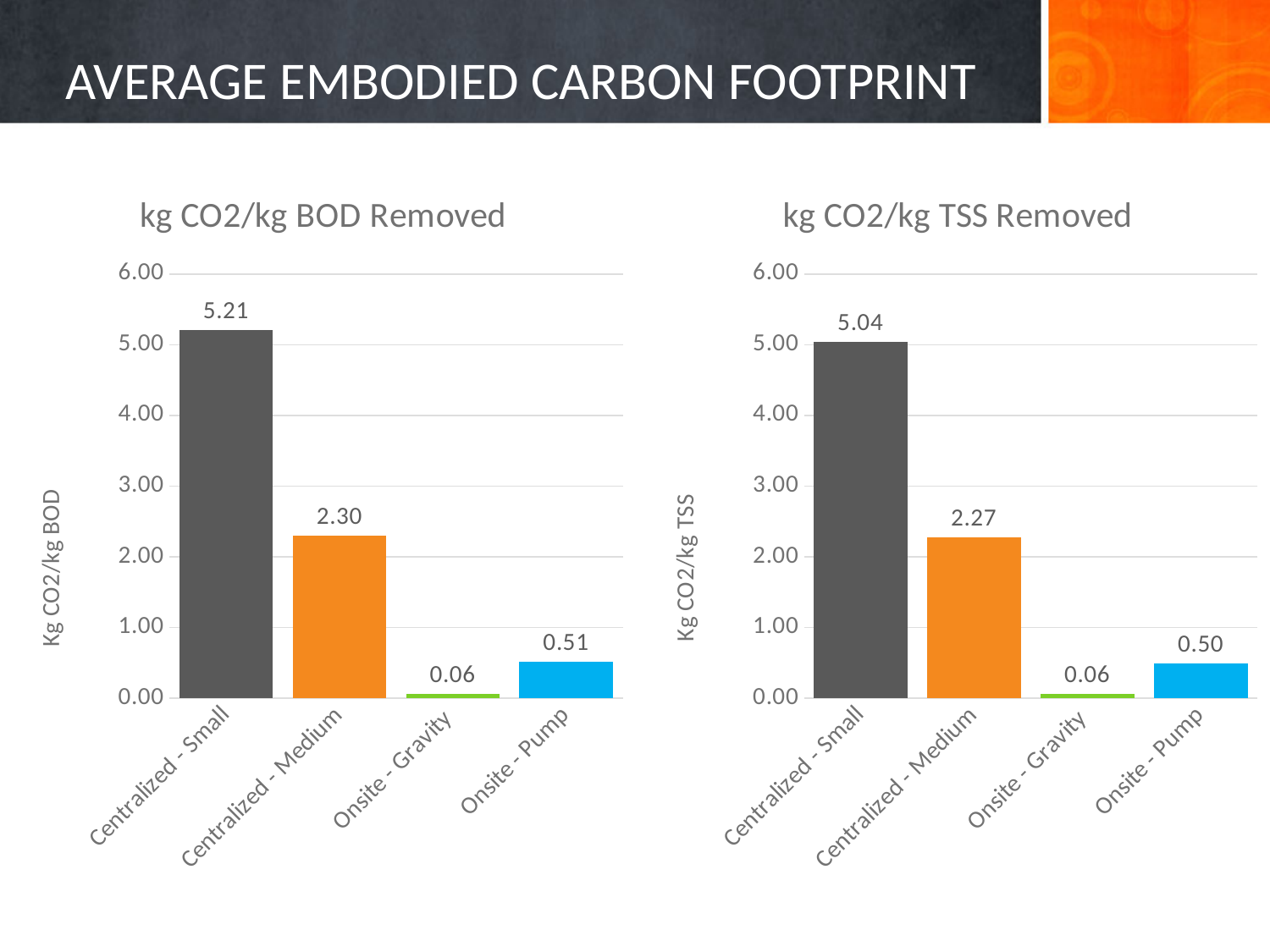
How many categories are shown in the 'kg CO2/kg BOD Removed' chart? 4 In the 'kg CO2/kg BOD Removed' chart, which category has the highest value? Centralized - Small In the 'kg CO2/kg BOD Removed' chart, what is the value for Centralized - Small? 5.21 In the 'kg CO2/kg TSS Removed' chart, what is the difference between Onsite - Pump and Onsite - Gravity? 0.44 In the 'kg CO2/kg TSS Removed' chart, which category has the lowest value? Onsite - Gravity In the 'kg CO2/kg BOD Removed' chart, which is larger: Onsite - Pump or Onsite - Gravity? Onsite - Pump In the 'kg CO2/kg BOD Removed' chart, what is the difference between Centralized - Small and Centralized - Medium? 2.91 What is the y-axis label of the 'kg CO2/kg BOD Removed' chart? Kg CO2/kg BOD In the 'kg CO2/kg TSS Removed' chart, what is the value for Centralized - Medium? 2.27 What kind of chart is the 'kg CO2/kg TSS Removed' chart? bar chart In the 'kg CO2/kg TSS Removed' chart, what is the value for Onsite - Pump? 0.50 In the 'kg CO2/kg TSS Removed' chart, is the value for Centralized - Small greater or less than 4.00? greater